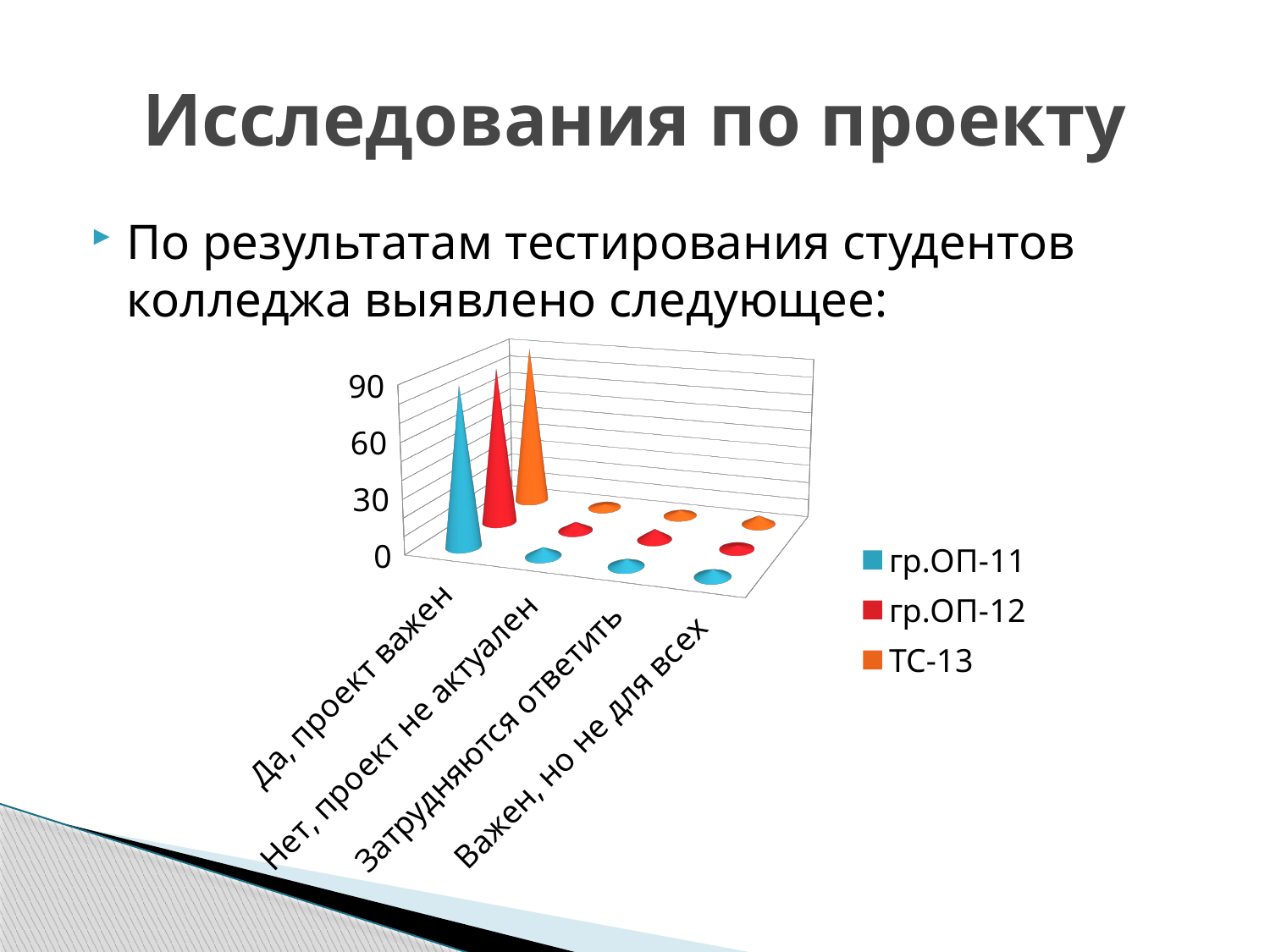
How many series does the chart legend list? 3 Which colour represents the series ТС-13 in the chart? orange Is the value for "Да, проект важен" in series гр.ОП-11 greater or less than 60? greater Which category has the highest value for the series гр.ОП-11? Да, проект важен Is the value for "Нет, проект не актуален" in series гр.ОП-12 greater or less than 30? less Is the value for "Важен, но не для всех" in series ТС-13 greater or less than 30? less How many categories are shown on the x axis of the chart? 4 For series гр.ОП-12, which is larger: the value for "Да, проект важен" or for "Затрудняются ответить"? Да, проект важен Which category has the highest value for the series ТС-13? Да, проект важен What kind of chart is shown on the slide? bar chart What is the highest tick value shown on the vertical axis of the chart? 90 Which series are listed in the chart legend? гр.ОП-11, гр.ОП-12, ТС-13